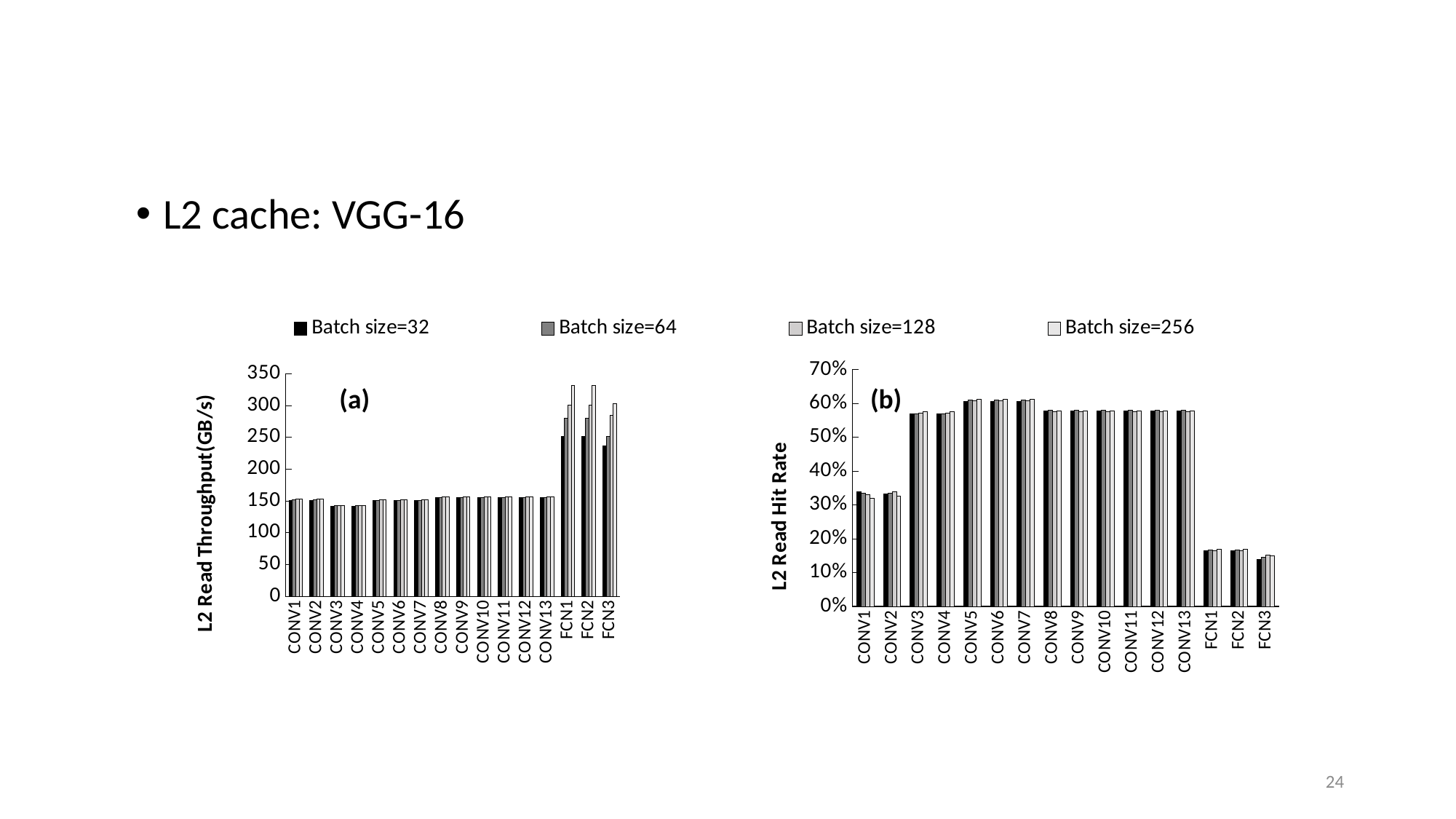
In chart (b), L2 Read Hit Rate, which layer has the lowest hit rate at Batch size=32? FCN3 In chart (b), L2 Read Hit Rate, which is larger: CONV3 at Batch size=64 or FCN1 at Batch size=64? CONV3 at Batch size=64 In chart (a), L2 Read Throughput, is the value for FCN3 at Batch size=32 greater or less than 200? greater In chart (a), L2 Read Throughput, is the value for CONV3 at Batch size=32 greater or less than 150? less What is the y-axis label of chart (b)? L2 Read Hit Rate In chart (b), L2 Read Hit Rate, is the value for CONV1 at Batch size=32 greater or less than 40%? less In chart (a), L2 Read Throughput, which is larger: FCN2 at Batch size=32 or CONV13 at Batch size=32? FCN2 at Batch size=32 How many layer categories are shown on the x axis of chart (b), L2 Read Hit Rate? 16 What kind of chart is chart (a), L2 Read Throughput? bar chart How many batch-size series does the legend list? 4